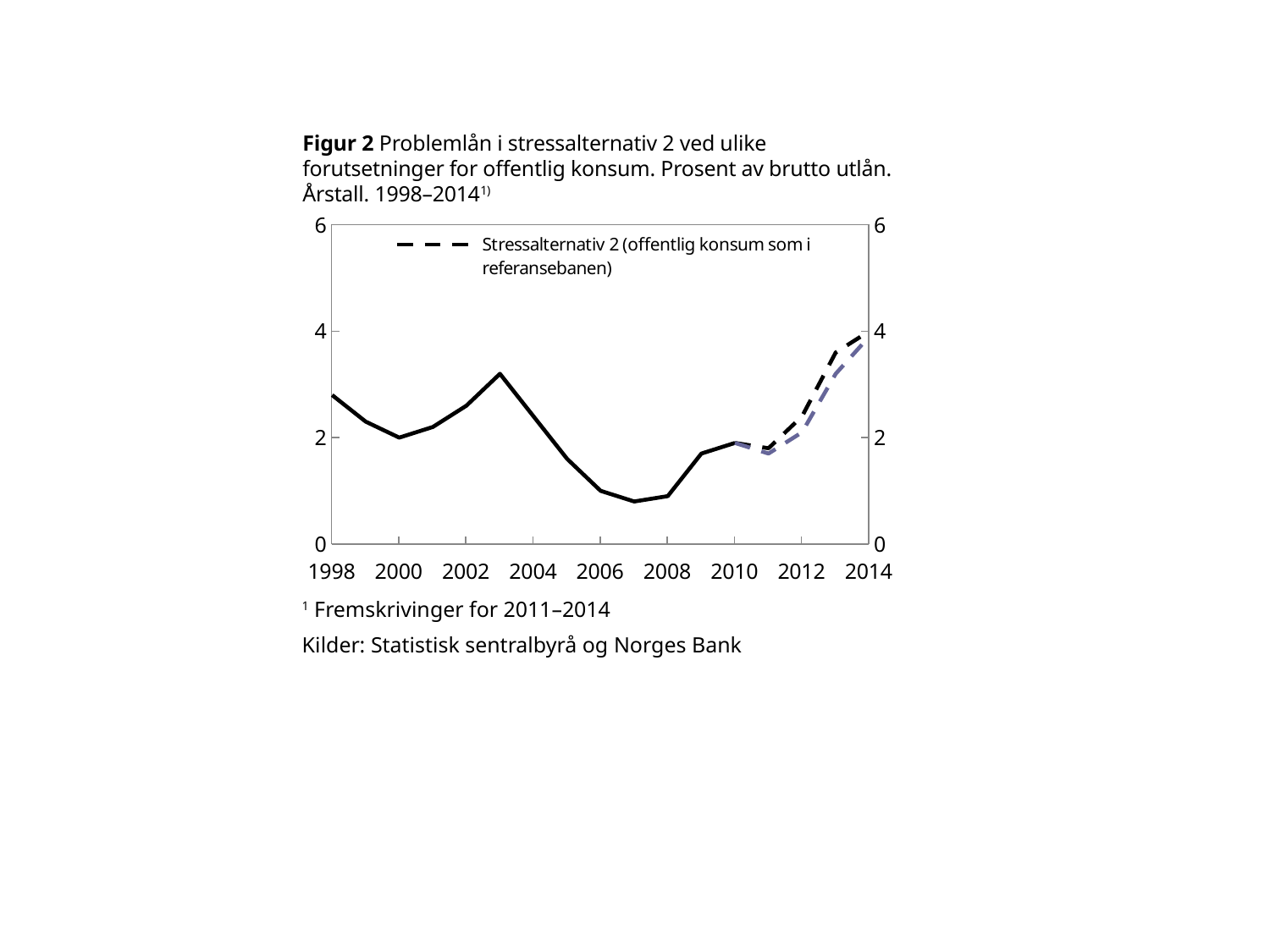
Which is larger, the value for 2003 or the value for 2010? 2003 Do the values rise or fall from 2003 to 2007? fall Is the value for 1998 greater or less than 2? greater Is the value for 2007 greater or less than 2? less Which year has the highest value on the chart? 2014 Which year has the lower value, 2003 or 2007? 2007 Is the value for 2003 greater or less than 2? greater Do the values rise or fall from 2010 to 2014? rise What kind of chart is shown on the slide? line chart What is the highest value shown on the vertical axis? 6